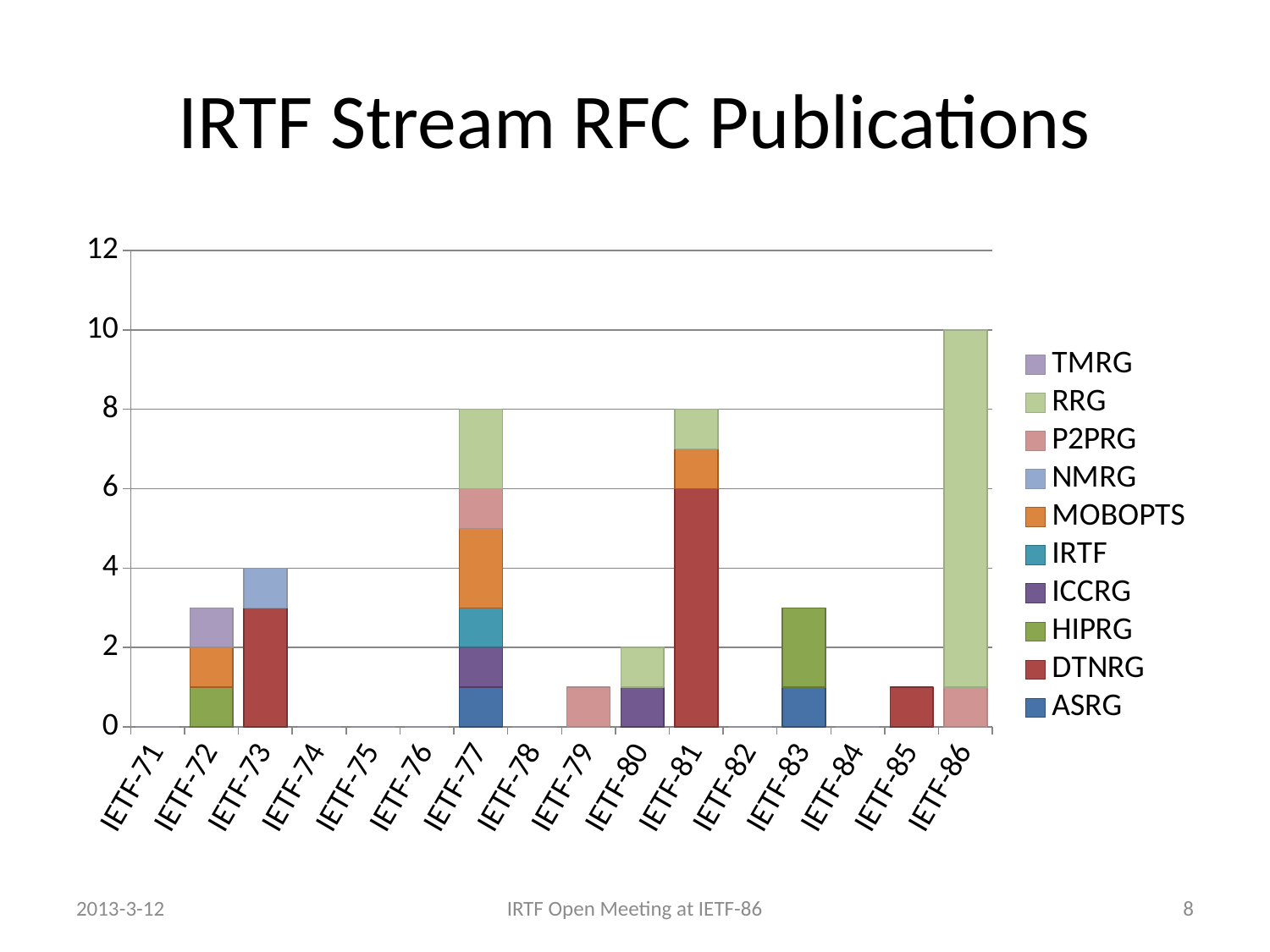
What is the total height of the stacked bar for IETF-73? 4 How many series does the legend list? 10 What is the difference between the total for IETF-77 and the total for IETF-80? 6 What is the title of the chart? IRTF Stream RFC Publications Which has a larger total, IETF-86 or IETF-81? IETF-86 Is the total value for IETF-83 greater or less than 2? greater What is the total height of the stacked bar for IETF-81? 8 What is the total height of the stacked bar for IETF-86? 10 Which IETF meeting has the highest total number of RFC publications? IETF-86 What is the value of the DTNRG segment for IETF-81? 6 How many IETF meeting categories are shown on the x axis? 16 What type of chart is shown on the slide? stacked bar chart